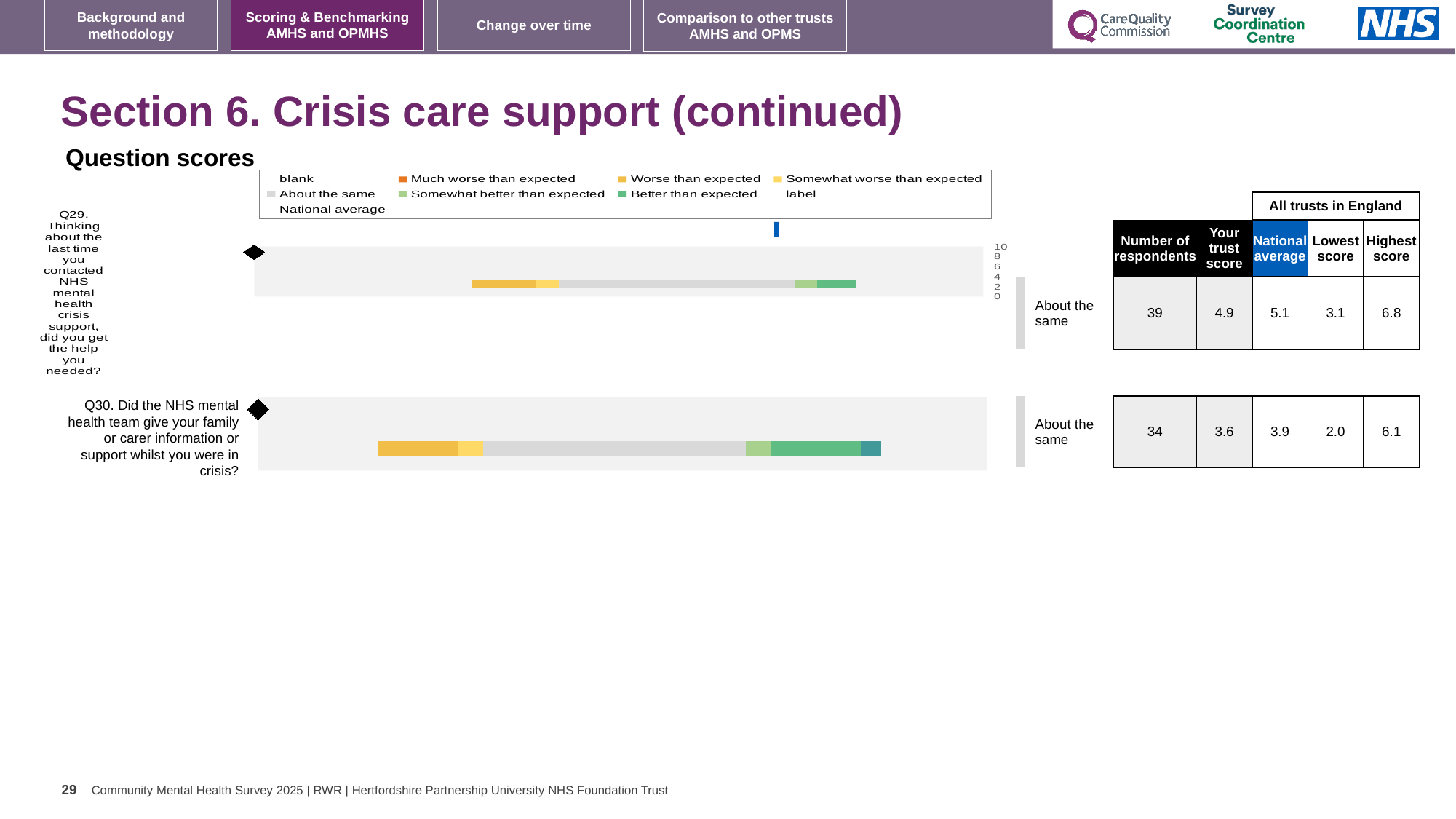
What benchmark rating is shown next to the bar for Q29? About the same How many respondents answered Q29? 39 What benchmark rating is shown next to the bar for Q30? About the same What is the trust score for Q30 shown alongside the chart? 3.6 What kind of chart is used to show the question scores for Q29 and Q30? bar chart What is the trust score for Q29 shown alongside the chart? 4.9 In the question scores chart legend, which entry is shown in light grey? About the same How many entries does the legend of the question scores chart list? 9 Which question has the higher trust score, Q29 or Q30? Q29 In the question scores chart legend, which entry is shown in orange? Much worse than expected How many questions (categories) are plotted in the question scores chart? 2 What is the difference between the national average and the trust score for Q30? 0.3